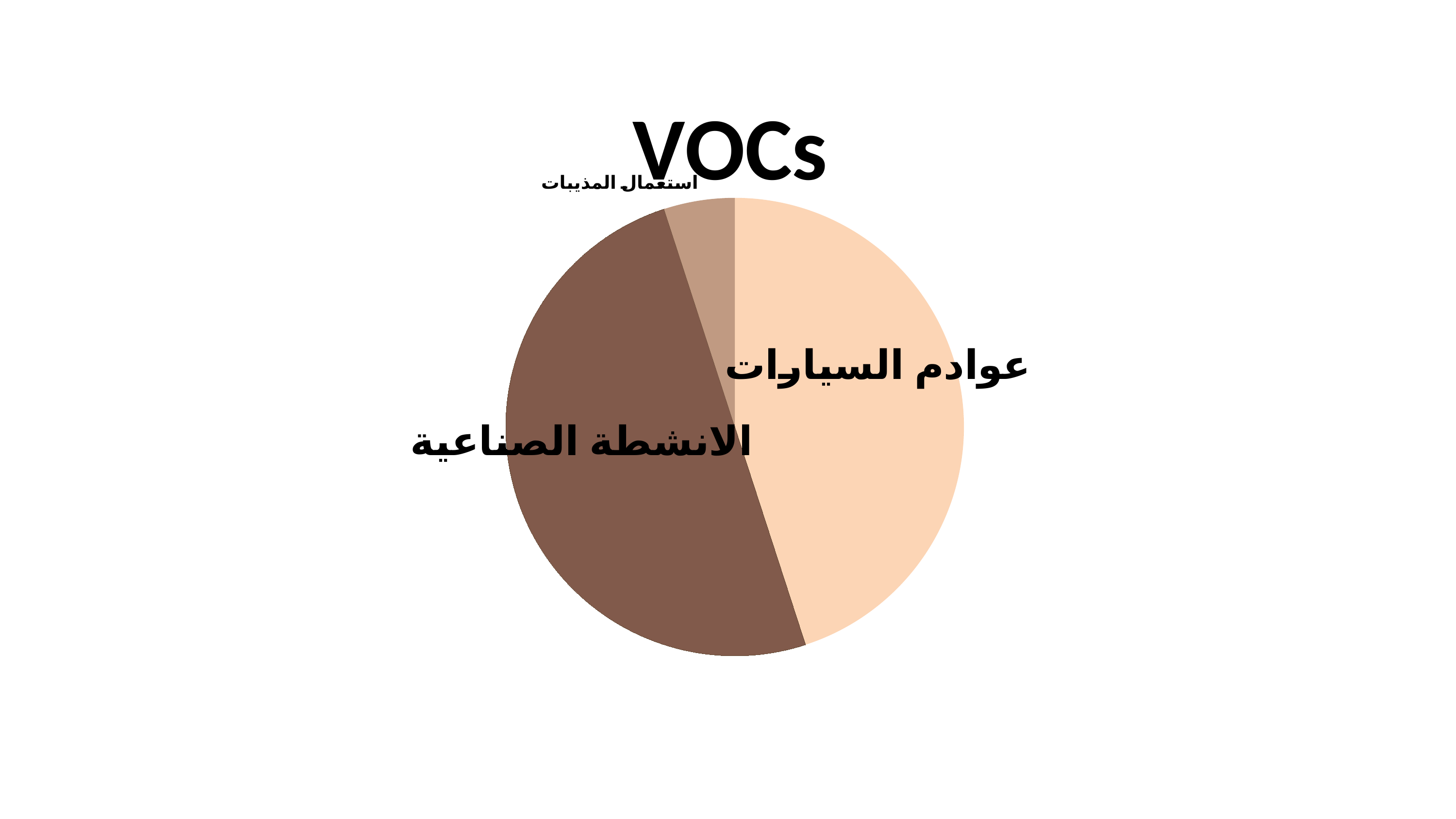
How many slices does the pie chart have? 3 Which category has the smallest slice in the pie chart? استعمال المذيبات Which category is shown by the darkest brown slice? الانشطة الصناعية Which slice is larger, عوادم السيارات or استعمال المذيبات? عوادم السيارات What kind of chart is shown on the slide? pie chart Which slice is larger, الانشطة الصناعية or استعمال المذيبات? الانشطة الصناعية What is the title of the pie chart? VOCs